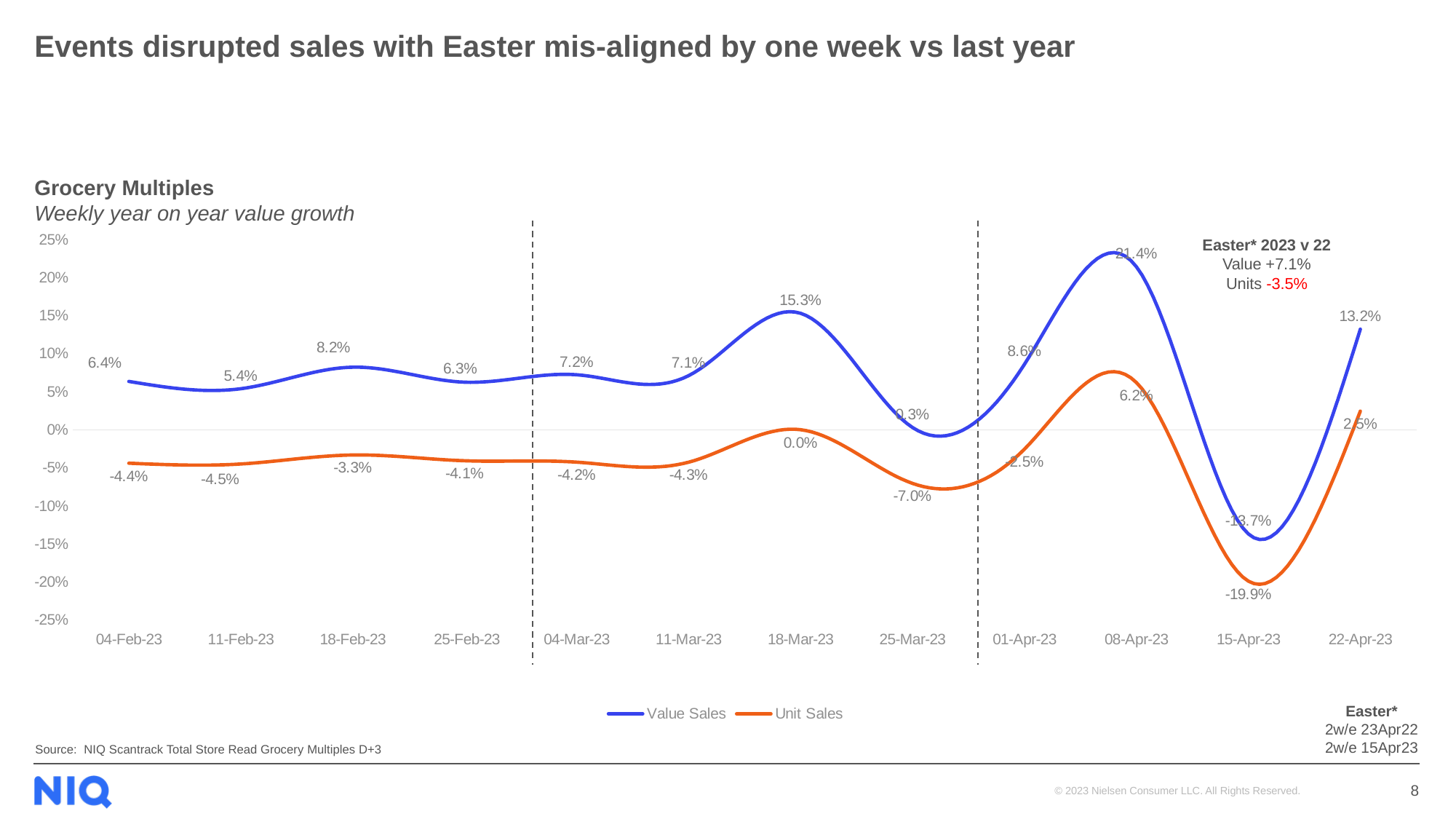
In which week is Value Sales growth highest? 08-Apr-23 How many series does the legend list? 2 What kind of chart is shown on the slide? Line chart What is the Value Sales growth for the week 22-Apr-23? 13.2% How many weekly data points are plotted along the x axis? 12 Which week has the higher Unit Sales growth, 18-Feb-23 or 25-Feb-23? 18-Feb-23 What is the Value Sales growth for the week 18-Mar-23? 15.3% What is the Unit Sales growth for the week 25-Mar-23? -7.0% What is the difference between Value Sales growth on 18-Feb-23 and 04-Feb-23? 1.8 percentage points What is the Unit Sales growth for the week 18-Mar-23? 0.0% In which week is Unit Sales growth lowest? 15-Apr-23 Is the Value Sales growth for 15-Apr-23 greater or less than -10%? less